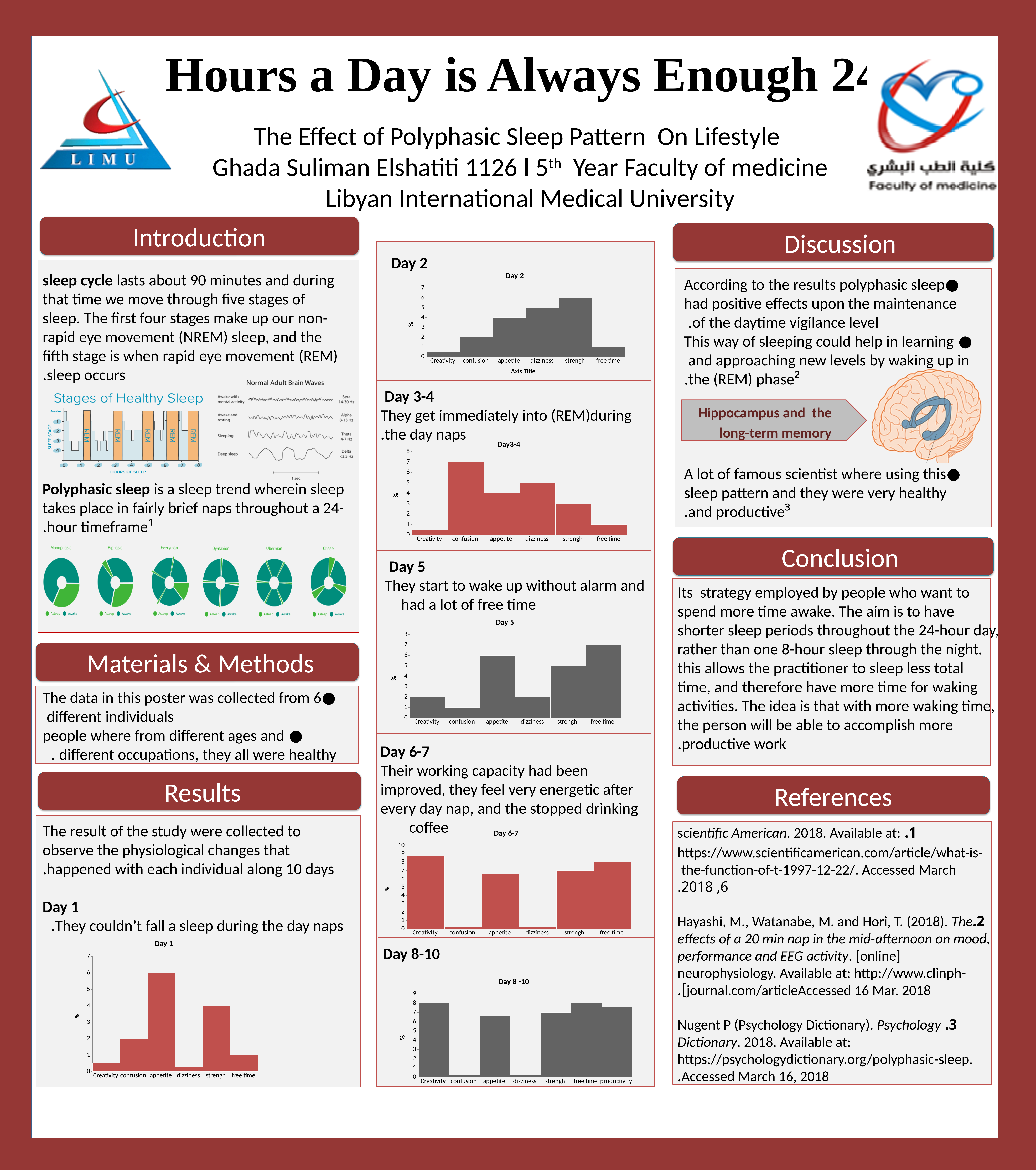
What type of chart is the Day 1 chart? bar chart In the Day 1 chart, which category has the highest value? appetite In the Day 3-4 chart, which category has the highest value? confusion In the Day 6-7 chart, is the value for Creativity greater or less than 8? greater In the Day 8-10 chart, is the value for confusion greater or less than 1? less In the Day 5 chart, which is larger, appetite or strengh? appetite In the Day 2 chart, which category has the highest value? strengh In the Day 1 chart, what is the value for appetite? 6 In the Day 3-4 chart, what is the value for confusion? 7 How many categories are shown on the x axis of the Day 8-10 chart? 7 In the Day 2 chart, is the value for dizziness greater or less than 3? greater